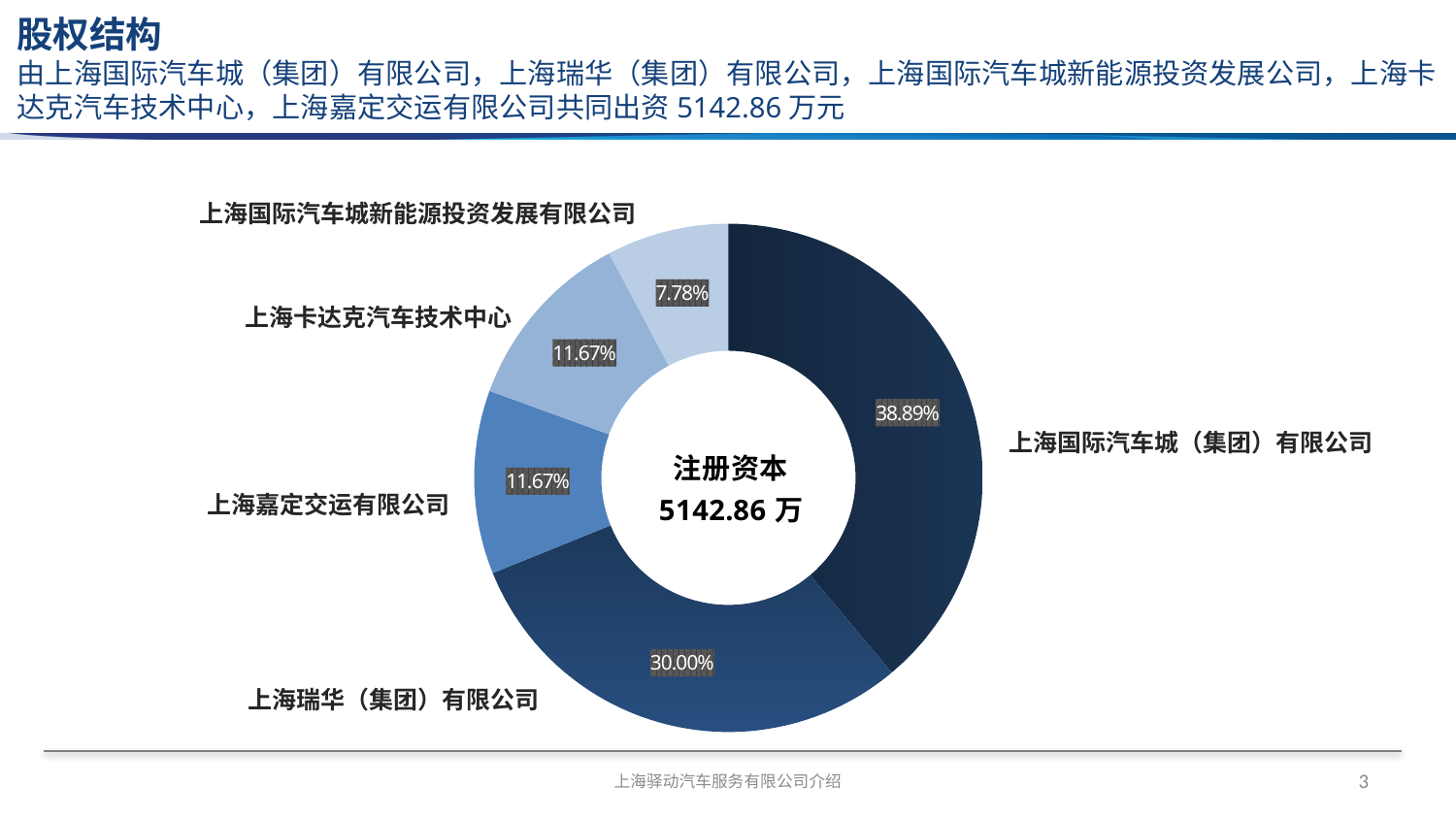
What share does 上海瑞华（集团）有限公司 hold? 30.00% How many shareholders are shown in the chart? 5 What share does 上海国际汽车城新能源投资发展有限公司 hold? 7.78% What share does 上海嘉定交运有限公司 hold? 11.67% What type of chart is shown on the slide? Pie chart (donut) Which holds a larger share, 上海卡达克汽车技术中心 or 上海国际汽车城新能源投资发展有限公司? 上海卡达克汽车技术中心 What is the difference between the shares of 上海国际汽车城（集团）有限公司 and 上海瑞华（集团）有限公司? 8.89% What share does 上海国际汽车城（集团）有限公司 hold? 38.89% Which shareholder holds the smallest share? 上海国际汽车城新能源投资发展有限公司 What is the combined share of 上海嘉定交运有限公司 and 上海卡达克汽车技术中心? 23.34% What registered capital is shown in the centre of the chart? 5142.86 万 Which shareholder holds the largest share? 上海国际汽车城（集团）有限公司